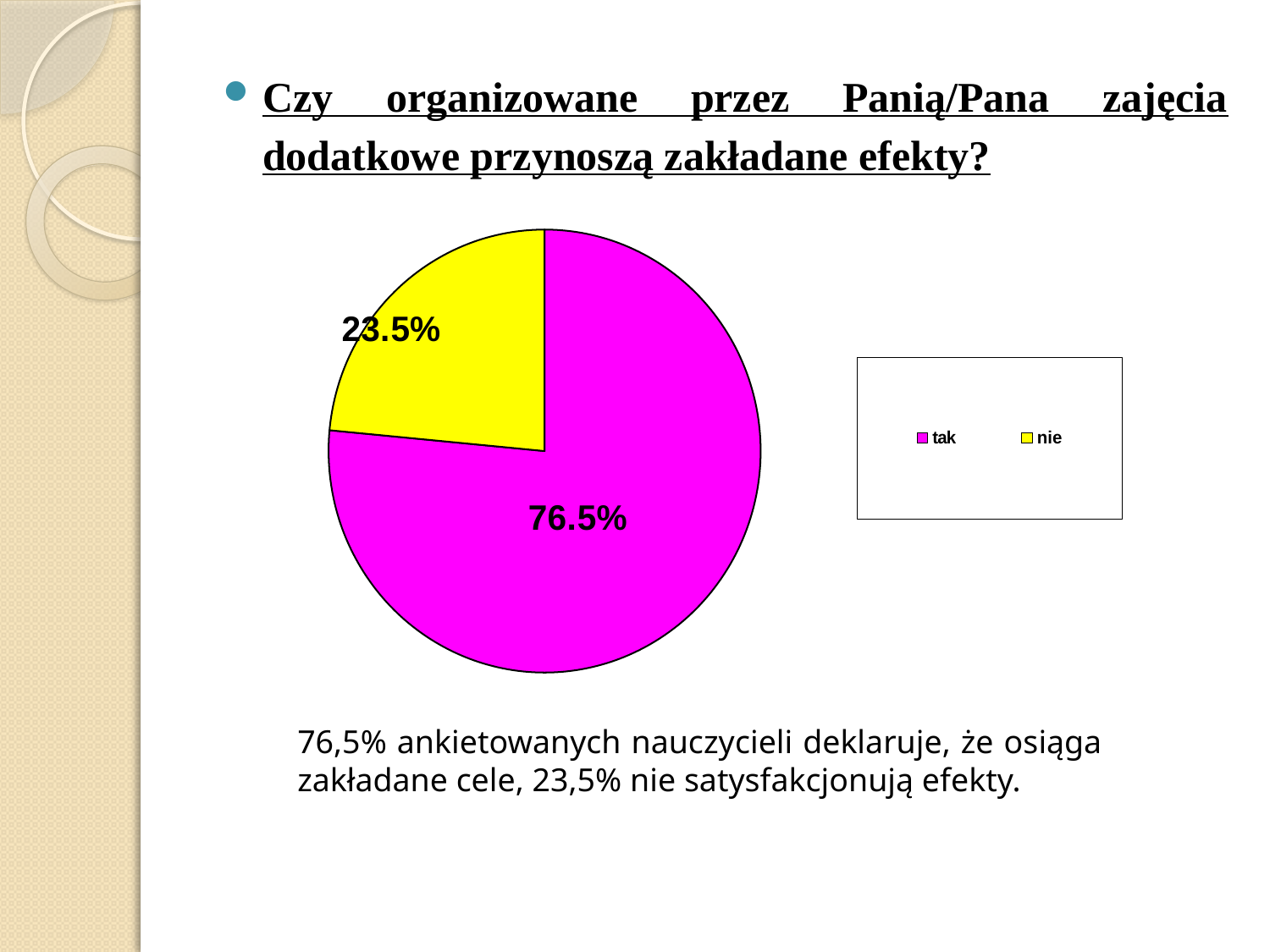
Which slice is the smallest in the pie chart? nie What share of the pie does the "tak" slice represent? 76.5% Which slice is the largest in the pie chart? tak What is the difference in percentage points between the "tak" and "nie" slices? 53 percentage points What kind of chart is shown on the slide? pie chart What share of the pie does the "nie" slice represent? 23.5% What colour is the "tak" slice? magenta Which slice is larger, "tak" or "nie"? tak How many slices does the pie chart have? 2 What colour is the "nie" slice? yellow How many entries does the legend list? 2